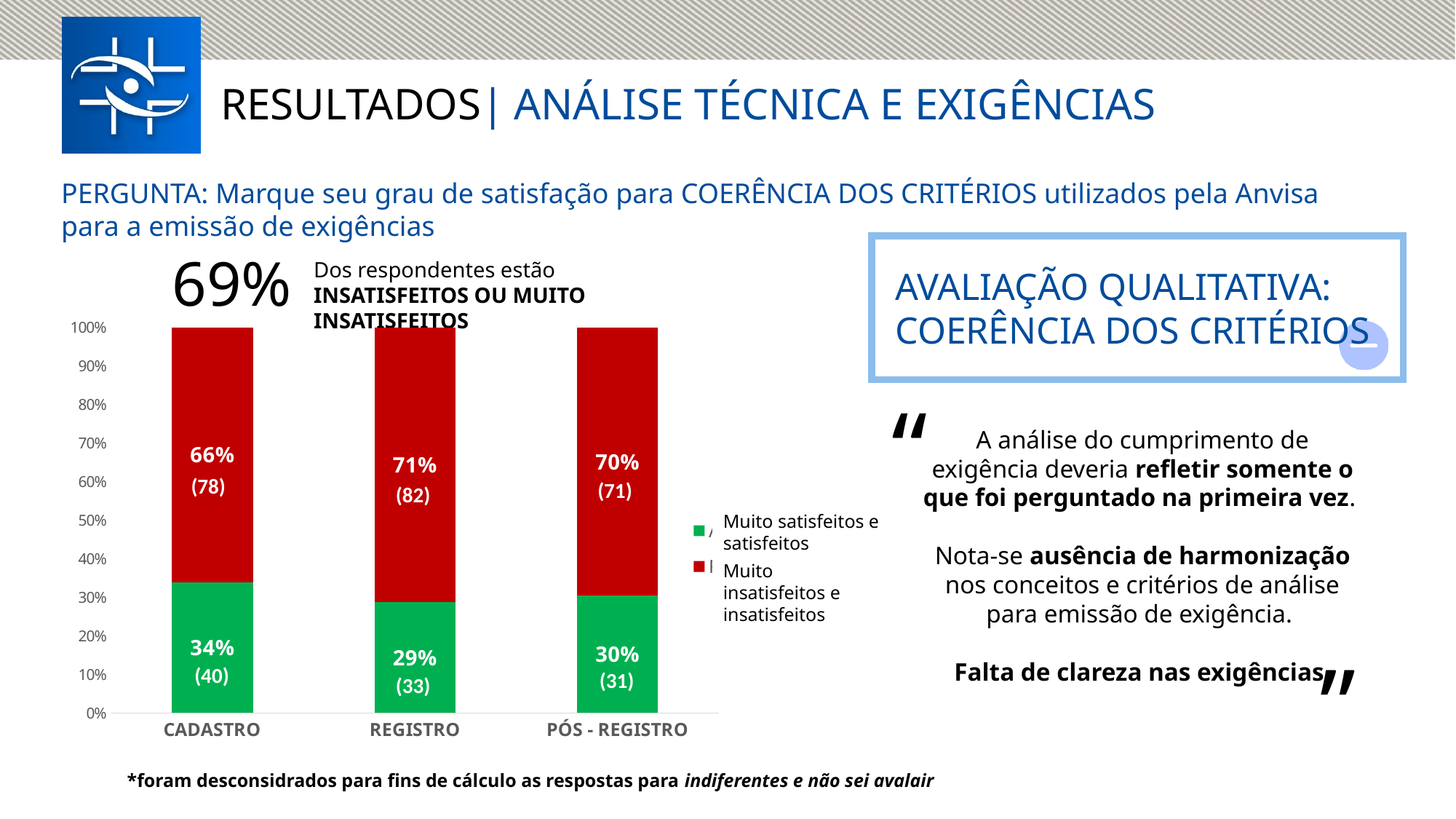
What percentage of respondents in the CADASTRO category are 'Muito insatisfeitos e insatisfeitos'? 66% Which colour represents 'Muito insatisfeitos e insatisfeitos' in the chart? Red How many categories are shown on the x axis of the chart? 3 How many respondents in the PÓS - REGISTRO category are 'Muito insatisfeitos e insatisfeitos'? 71 What is the total number of respondents counted for the REGISTRO category (sum of both series)? 115 Which category has the highest percentage of 'Muito insatisfeitos e insatisfeitos' respondents? REGISTRO What is the difference in percentage points between the 'Muito insatisfeitos e insatisfeitos' share for REGISTRO and for CADASTRO? 5 Which is larger: the 'Muito satisfeitos e satisfeitos' percentage for CADASTRO or for PÓS - REGISTRO? CADASTRO How many series does the chart legend list? 2 What kind of chart is shown on the slide? Stacked bar chart Which category has the lowest percentage of 'Muito satisfeitos e satisfeitos' respondents? REGISTRO What percentage of respondents in the REGISTRO category are 'Muito satisfeitos e satisfeitos'? 29%